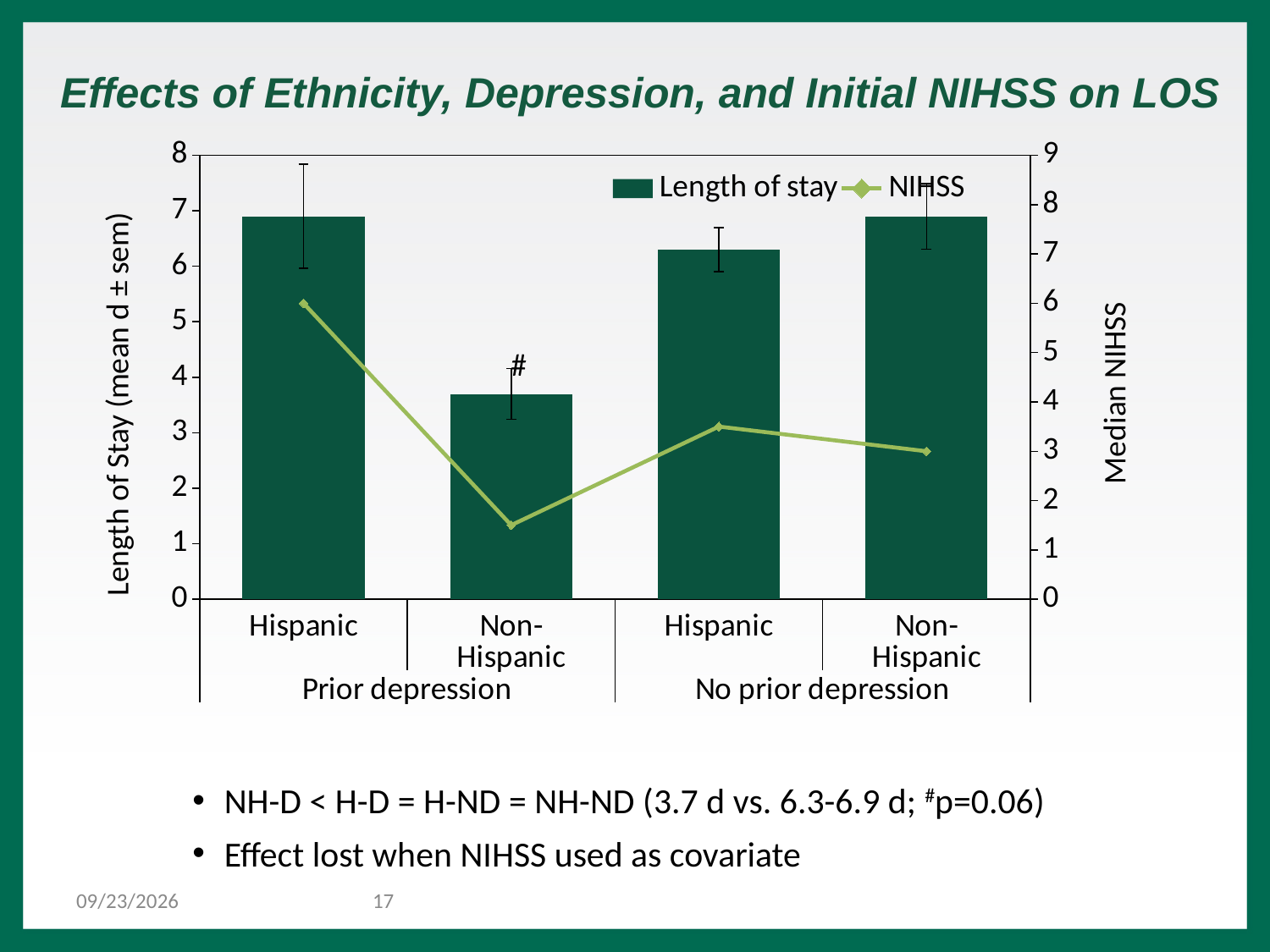
What is the title of the left vertical axis? Length of Stay (mean d ± sem) What kind of chart is shown on the slide? A combination bar and line chart Which group has the lowest Length of stay bar? Non-Hispanic, Prior depression Is the Length of stay for Non-Hispanic patients with no prior depression greater or less than 6? greater Which is larger, the Length of stay for Hispanic or Non-Hispanic patients with prior depression? Hispanic Is the Length of stay for Non-Hispanic patients with prior depression greater or less than 4? less How many series does the legend list? 2 Which group has the highest Median NIHSS on the line series? Hispanic, Prior depression Is the Length of stay for Hispanic patients with prior depression greater or less than 6? greater How many bars are plotted in the chart? 4 What is the title of the right vertical axis? Median NIHSS